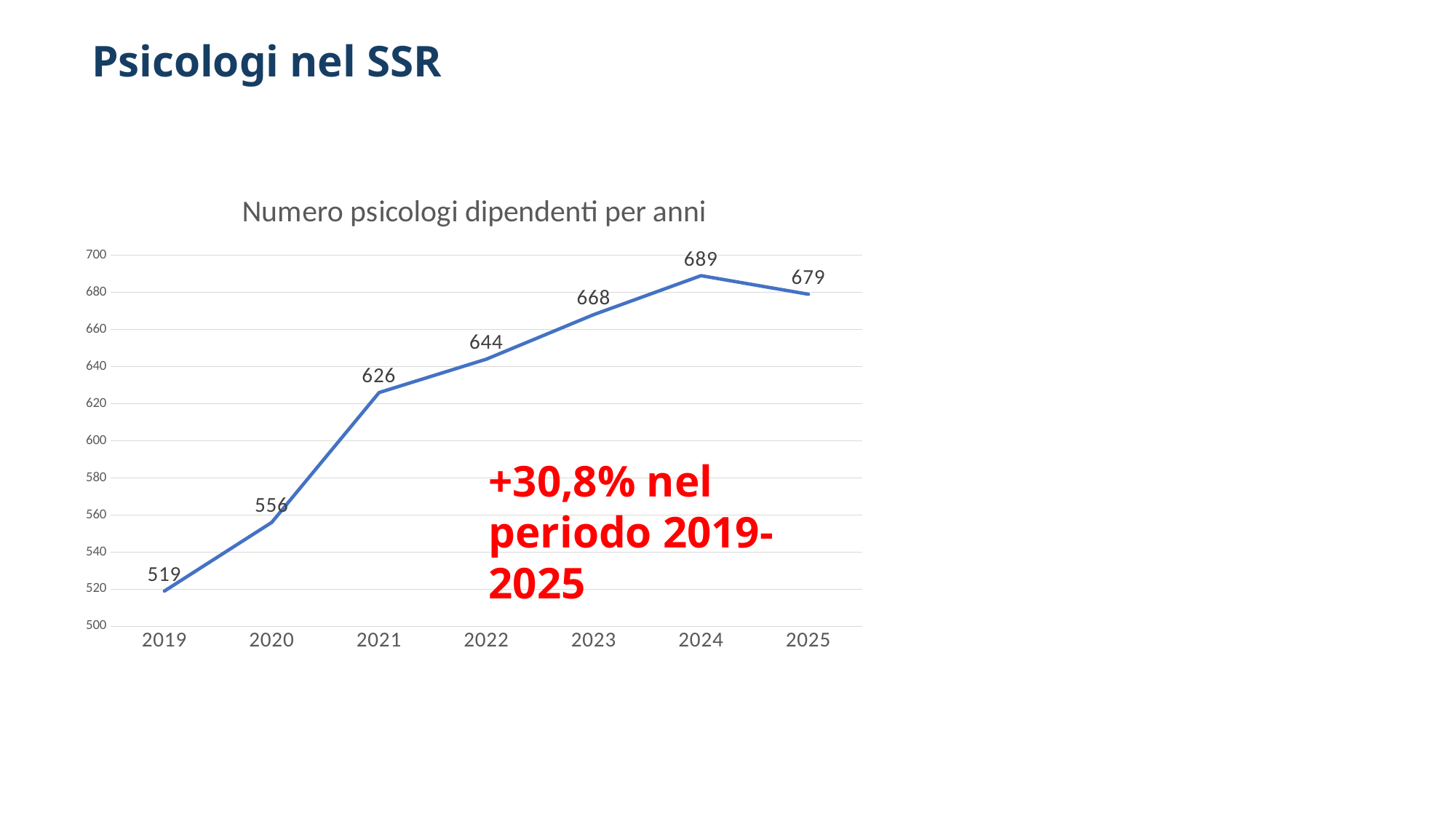
What is the value for 2025? 679 Is the value for 2021 greater or less than 600? greater How many years are plotted on the x axis? 7 What is the difference between the values for 2024 and 2025? 10 What is the value for 2022? 644 What is the title of the chart? Numero psicologi dipendenti per anni Which year has the highest value? 2024 What is the difference between the values for 2021 and 2020? 70 What is the value for 2019? 519 Which year has the lowest value? 2019 Which is larger, the value for 2023 or the value for 2025? 2025 What kind of chart is shown? line chart